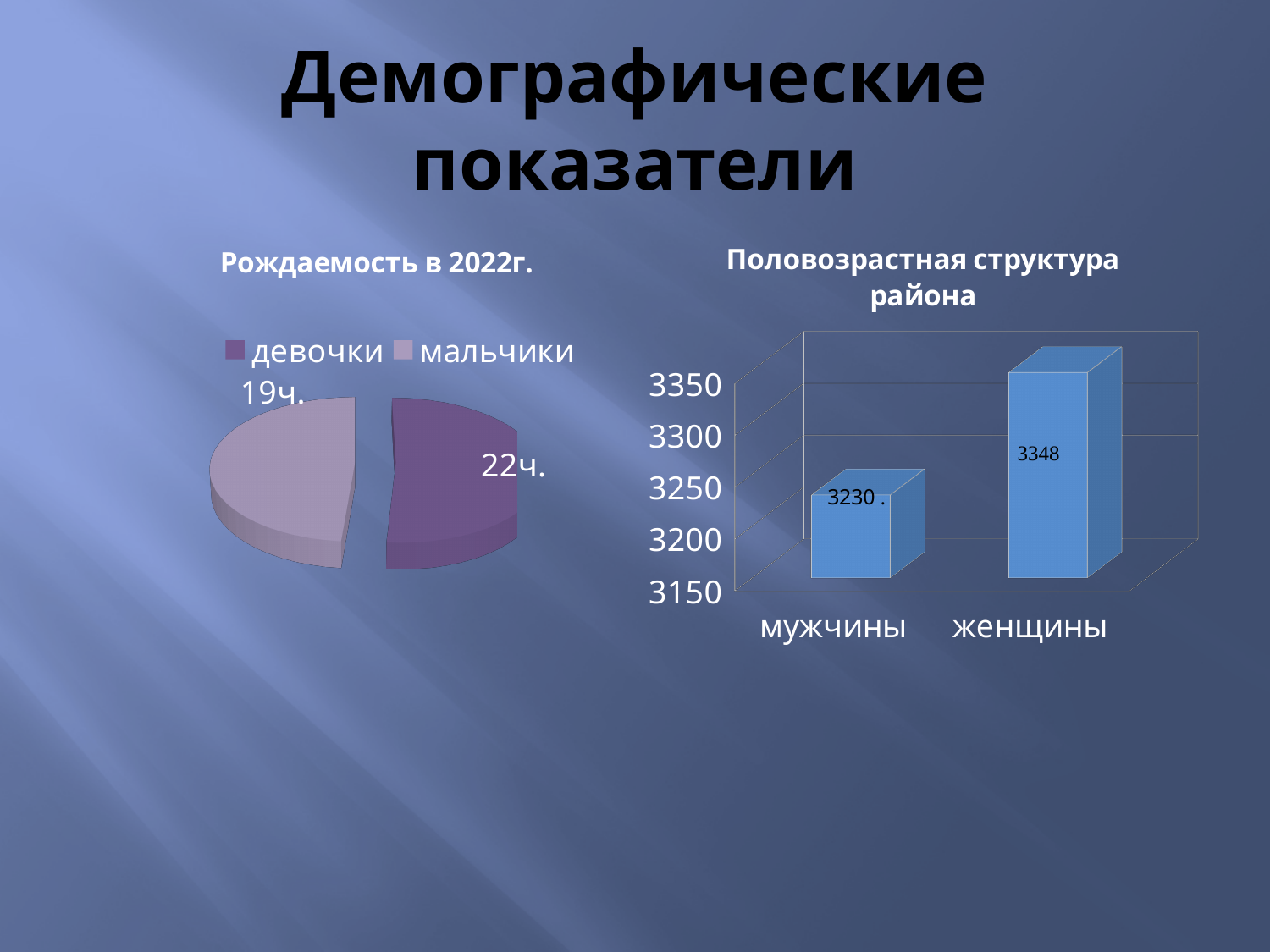
In the chart titled "Половозрастная структура района", what is the value for мужчины? 3230 In the chart titled "Рождаемость в 2022г.", what is the value for девочки? 22ч. In the chart titled "Половозрастная структура района", is the value for мужчины greater or less than 3250? less In the chart titled "Половозрастная структура района", what is the value for женщины? 3348 In the chart titled "Половозрастная структура района", which category has the lowest value? мужчины What kind of chart is the one titled "Рождаемость в 2022г."? pie chart In the chart titled "Половозрастная структура района", what is the difference between the values for женщины and мужчины? 118 In the chart titled "Рождаемость в 2022г.", how many series does the legend list? 2 In the chart titled "Рождаемость в 2022г.", which category has the larger slice? девочки What kind of chart is the one titled "Половозрастная структура района"? bar chart In the chart titled "Рождаемость в 2022г.", what is the difference between the values for девочки and мальчики? 3 In the chart titled "Рождаемость в 2022г.", what is the value for мальчики? 19ч.